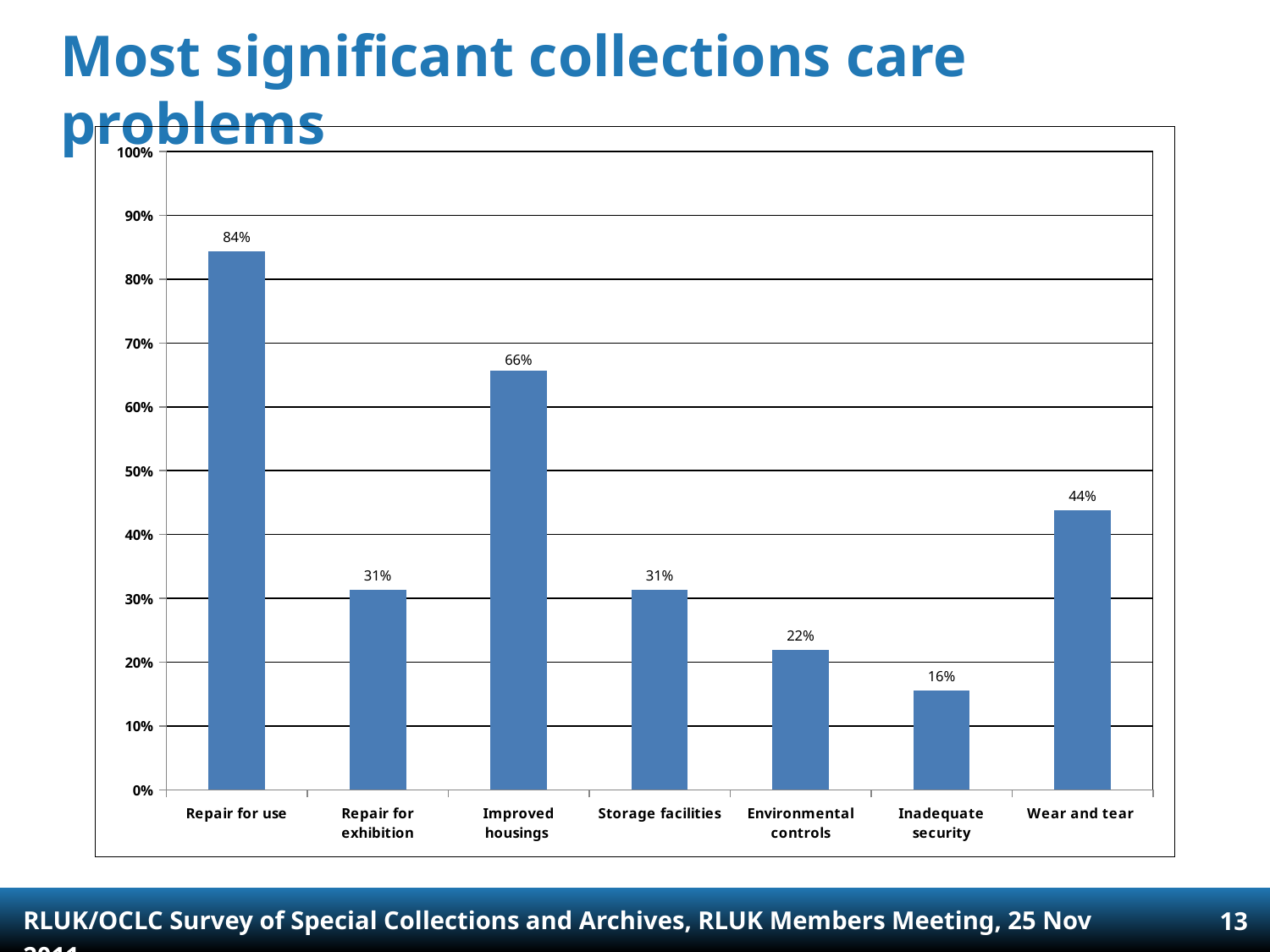
What is the value for Inadequate security? 16% What is the difference between the values for Repair for use and Improved housings? 18% Which category has the highest value? Repair for use What is the value for Repair for use? 84% What kind of chart is shown on the slide? Bar chart Which is larger, the value for Wear and tear or the value for Storage facilities? Wear and tear What is the value for Improved housings? 66% What is the difference between the values for Wear and tear and Environmental controls? 22% How many categories are shown on the x axis? 7 Which category has the lowest value? Inadequate security What is the value for Environmental controls? 22% Is the value for Improved housings greater or less than 60%? greater